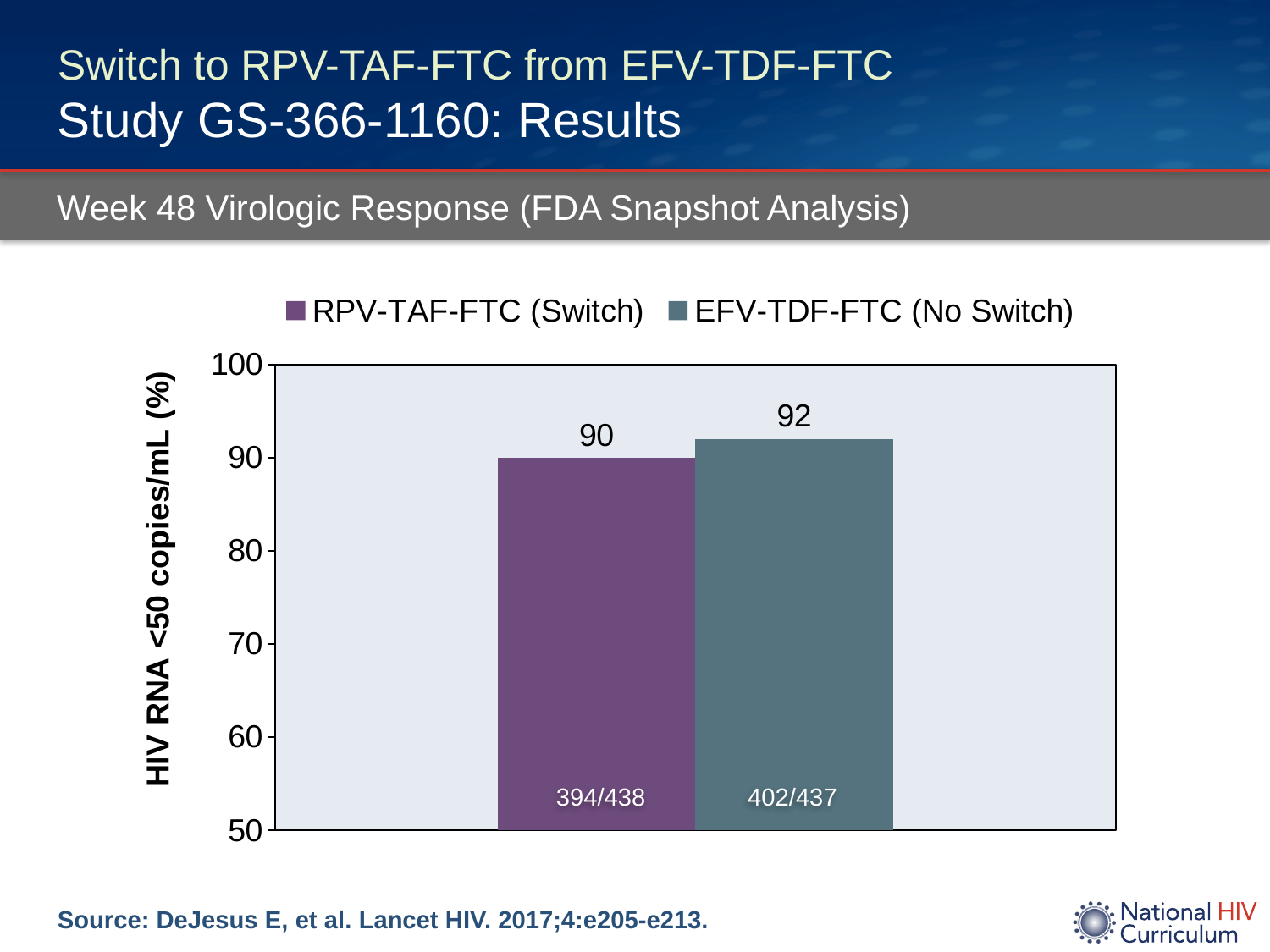
What fraction is printed inside the EFV-TDF-FTC (No Switch) bar? 402/437 What fraction is printed inside the RPV-TAF-FTC (Switch) bar? 394/438 Which series has the higher value? EFV-TDF-FTC (No Switch) Which series has the lower value? RPV-TAF-FTC (Switch) What is the value for EFV-TDF-FTC (No Switch)? 92 What kind of chart is shown? bar chart What is the value for RPV-TAF-FTC (Switch)? 90 Is the value for RPV-TAF-FTC (Switch) greater or less than 80? greater What is the y-axis label of the chart? HIV RNA <50 copies/mL (%) Is the value for EFV-TDF-FTC (No Switch) greater or less than 100? less What is the difference between the EFV-TDF-FTC (No Switch) value and the RPV-TAF-FTC (Switch) value? 2 How many series does the legend list? 2